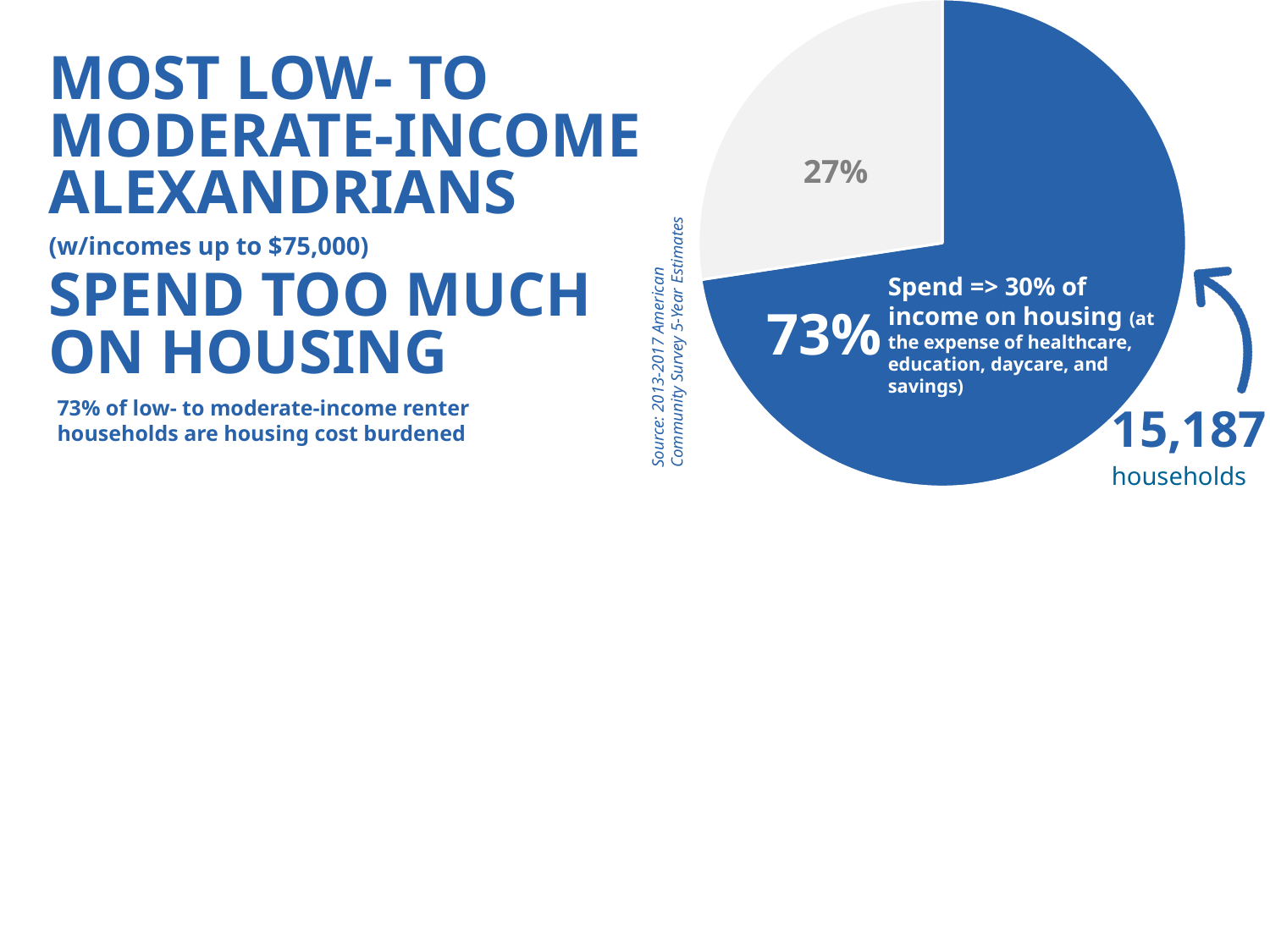
What is the data source cited for the chart? 2013-2017 American Community Survey 5-Year Estimates Which slice of the pie is the smallest? 27% (grey slice) Which slice of the pie is the largest? 73% (blue slice) What share of the pie is the light grey slice? 27% How many slices does the pie chart have? 2 What do the households in the 73% slice spend on housing, according to the label? => 30% of income How many households does the 73% slice represent, according to the slide? 15,187 Is the blue slice larger or smaller than the grey slice? larger What is the difference in percentage points between the 73% slice and the 27% slice? 46 percentage points What kind of chart is shown on the slide? pie chart What is the total of the two pie slice percentages? 100% What share of the pie is the blue slice? 73%